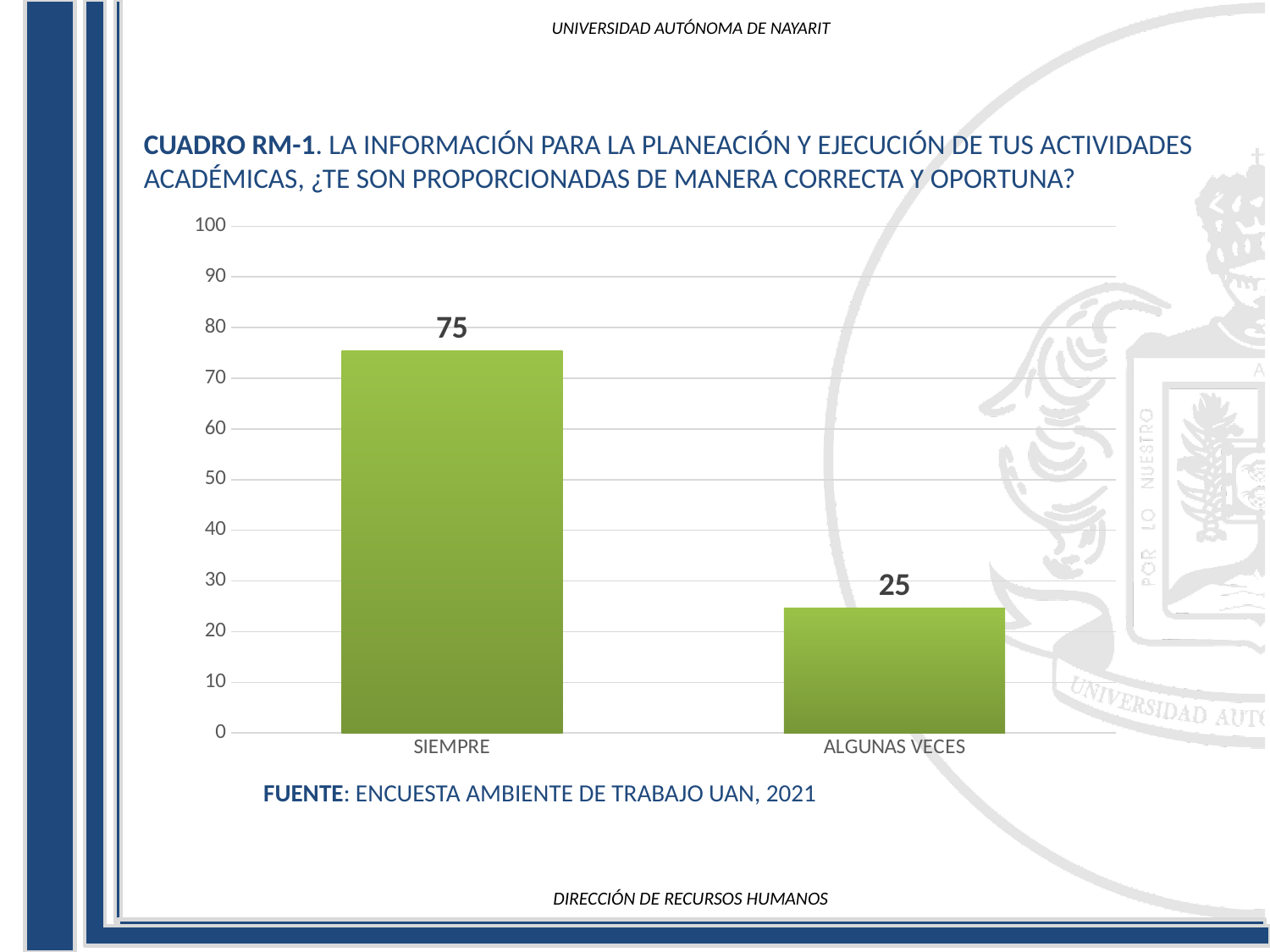
Is the value for ALGUNAS VECES greater or less than 30? less Which category has the highest value? SIEMPRE What kind of chart is shown on the slide? bar chart How many categories are shown on the x axis? 2 What is the value for SIEMPRE? 75 Is the value for SIEMPRE greater or less than 70? greater Which is larger, the value for SIEMPRE or the value for ALGUNAS VECES? SIEMPRE What source is cited below the chart? ENCUESTA AMBIENTE DE TRABAJO UAN, 2021 What is the difference between the values for SIEMPRE and ALGUNAS VECES? 50 What is the value for ALGUNAS VECES? 25 What is the maximum value shown on the vertical axis? 100 Which category has the lowest value? ALGUNAS VECES